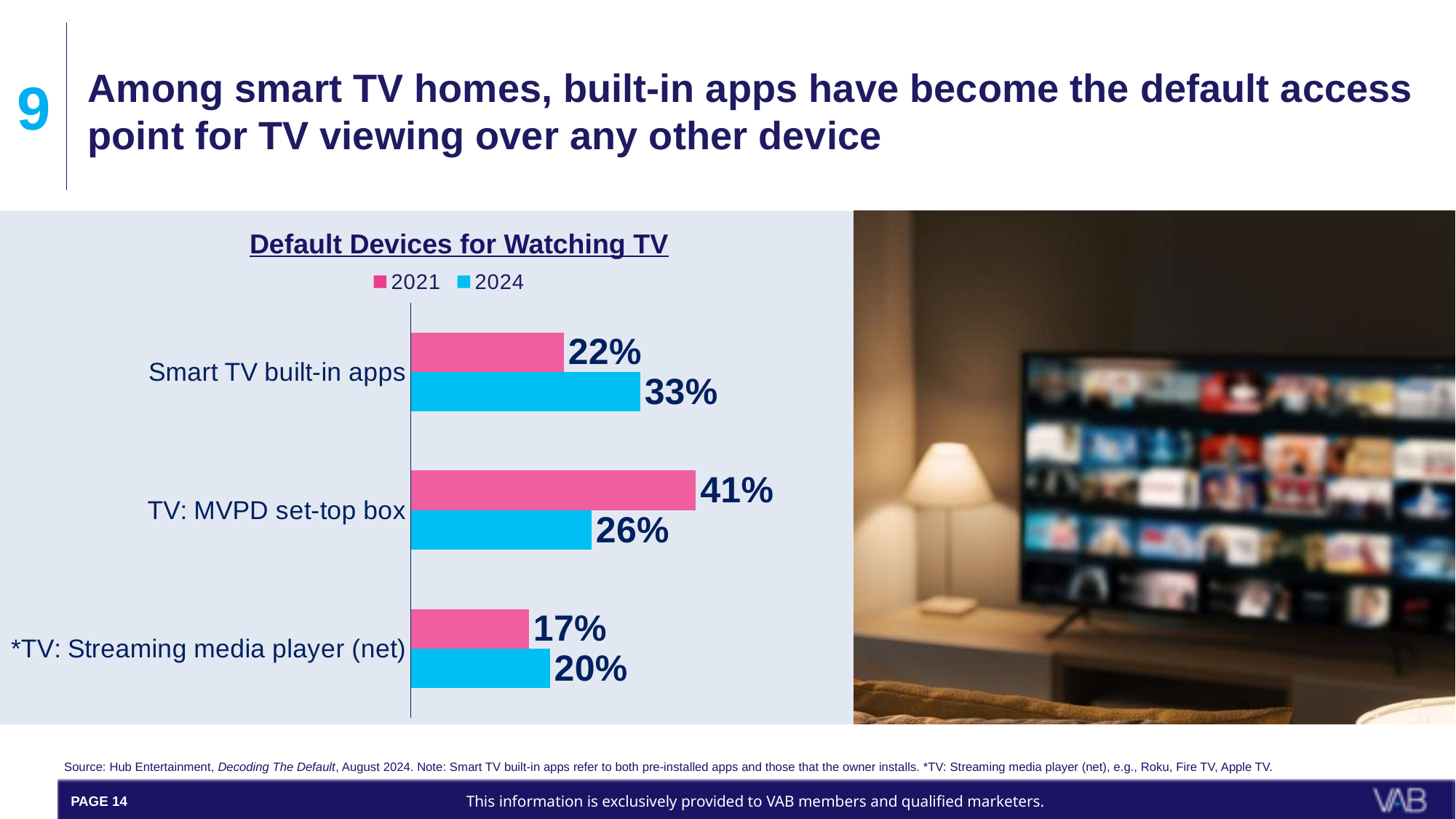
What is the difference between the 2021 and 2024 values for TV: MVPD set-top box? 15% What is the 2024 value for Smart TV built-in apps? 33% What is the 2024 value for *TV: Streaming media player (net)? 20% Which is larger for Smart TV built-in apps, the 2021 value or the 2024 value? 2024 Which category has the highest 2024 value? Smart TV built-in apps How many categories are shown in the chart? 3 How many series does the legend list? 2 What is the difference between the 2024 and 2021 values for Smart TV built-in apps? 11% What is the title of the chart? Default Devices for Watching TV Which category has the lowest 2021 value? *TV: Streaming media player (net) What kind of chart is shown on the slide? Bar chart What is the 2021 value for TV: MVPD set-top box? 41%